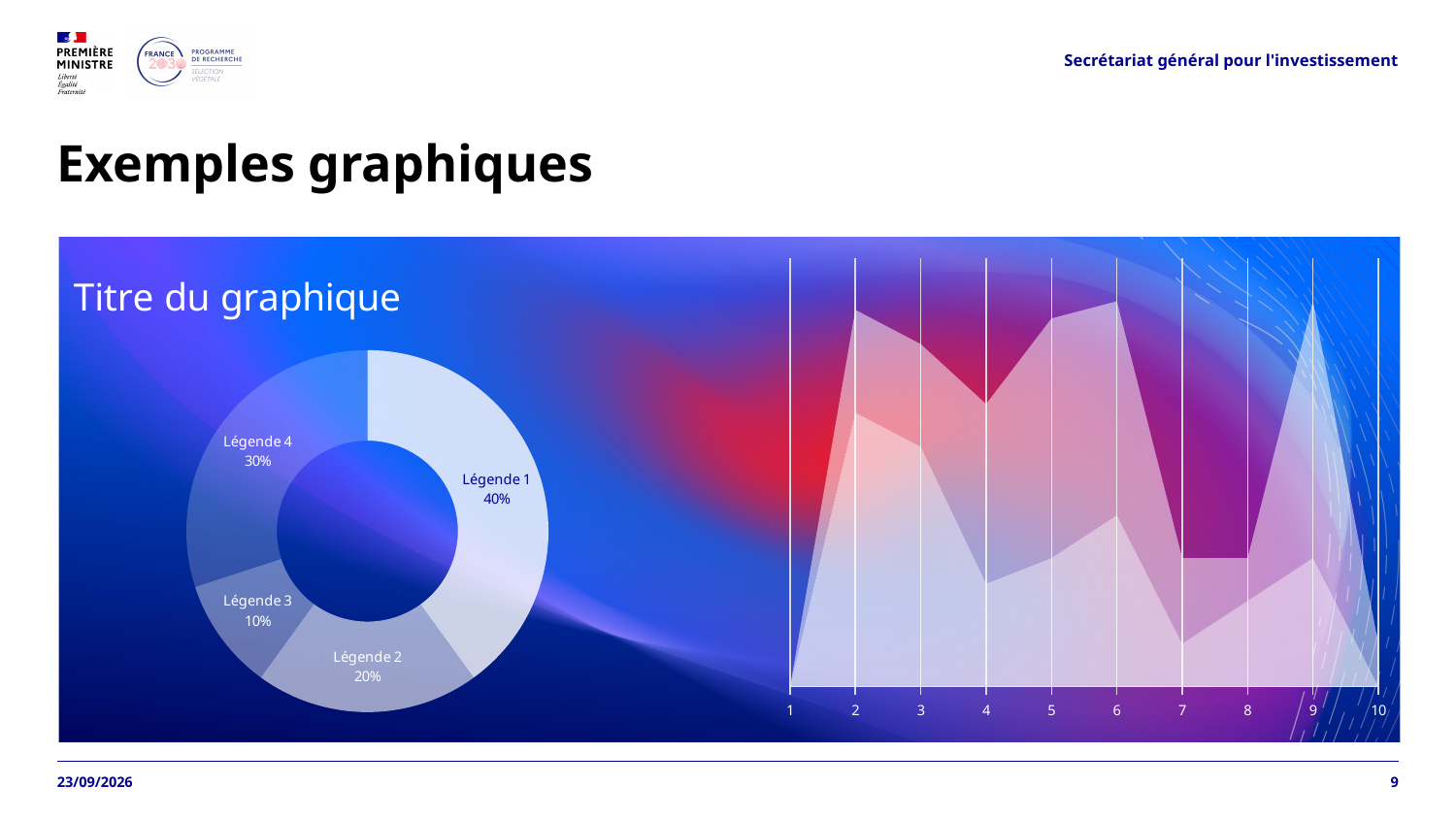
On the doughnut chart titled "Titre du graphique", which category has the largest share? Légende 1 How many points are labelled on the x axis of the area chart on the right? 10 On the doughnut chart titled "Titre du graphique", which is larger, Légende 4 or Légende 2? Légende 4 How many categories does the doughnut chart titled "Titre du graphique" show? 4 What kind of chart is the one on the right side of the slide? Area chart On the doughnut chart titled "Titre du graphique", what is the value for Légende 4? 30% On the doughnut chart titled "Titre du graphique", what is the value for Légende 3? 10% On the doughnut chart titled "Titre du graphique", what is the difference between Légende 1 and Légende 2? 20% On the area chart on the right, do the values rise or fall from point 1 to point 2? Rise On the doughnut chart titled "Titre du graphique", what is the value for Légende 1? 40% On the doughnut chart titled "Titre du graphique", which category has the smallest share? Légende 3 What kind of chart is the one on the left titled "Titre du graphique"? Doughnut chart